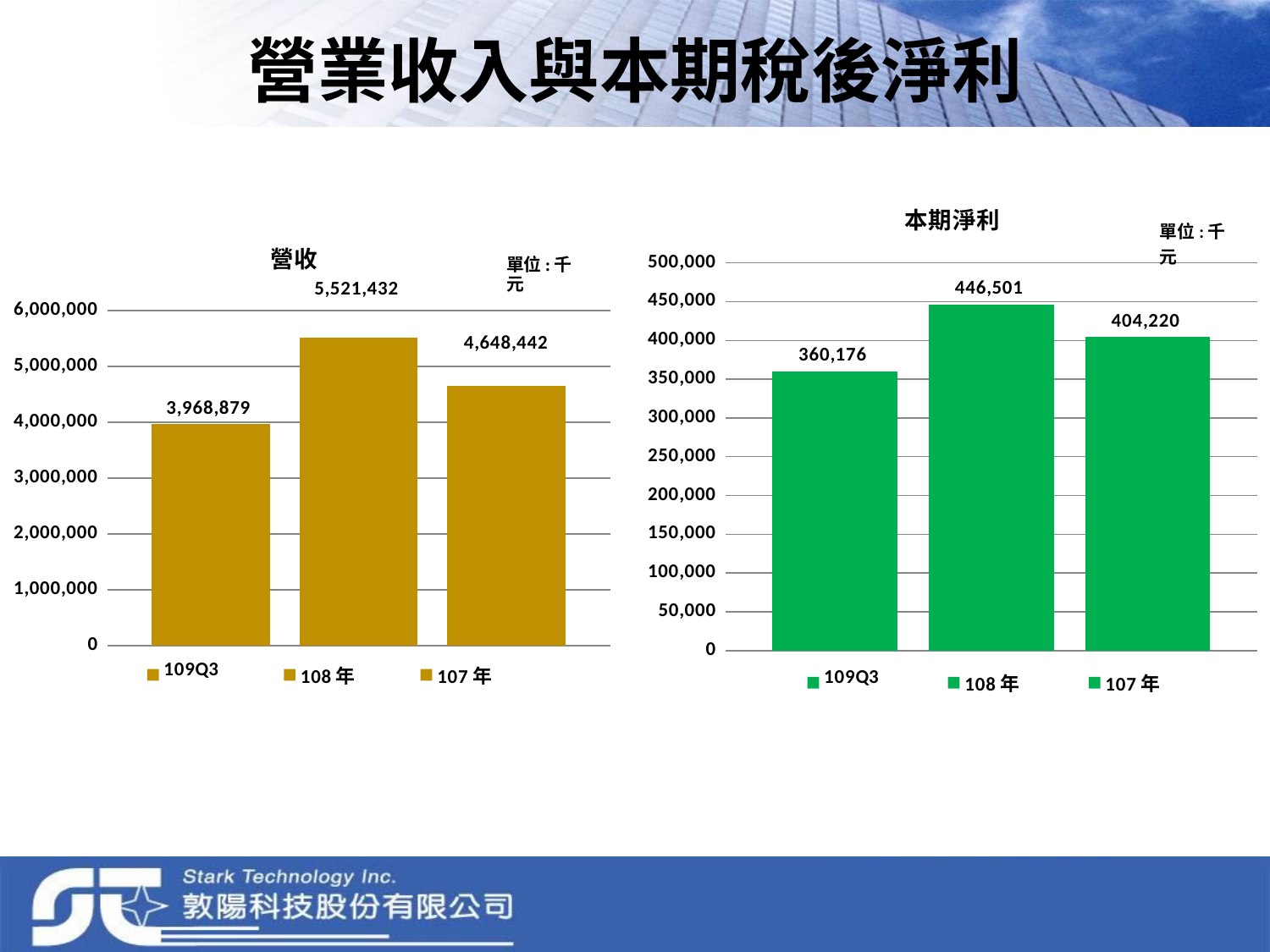
In the 營收 chart, what is the difference between the values for 108 年 and 109Q3? 1,552,553 What unit is stated for the values in the 本期淨利 chart? 千元 In the 本期淨利 chart, what is the difference between the values for 108 年 and 107 年? 42,281 In the 營收 chart, which category has the highest value? 108 年 In the 營收 chart, which is larger: the value for 107 年 or the value for 109Q3? 107 年 How many bars are shown in the 本期淨利 chart? 3 In the 營收 chart, what is the value for 108 年? 5,521,432 In the 營收 chart, what is the value for 109Q3? 3,968,879 In the 本期淨利 chart, what is the value for 109Q3? 360,176 What type of chart is the 營收 chart? bar chart In the 本期淨利 chart, what is the value for 107 年? 404,220 In the 本期淨利 chart, which category has the lowest value? 109Q3